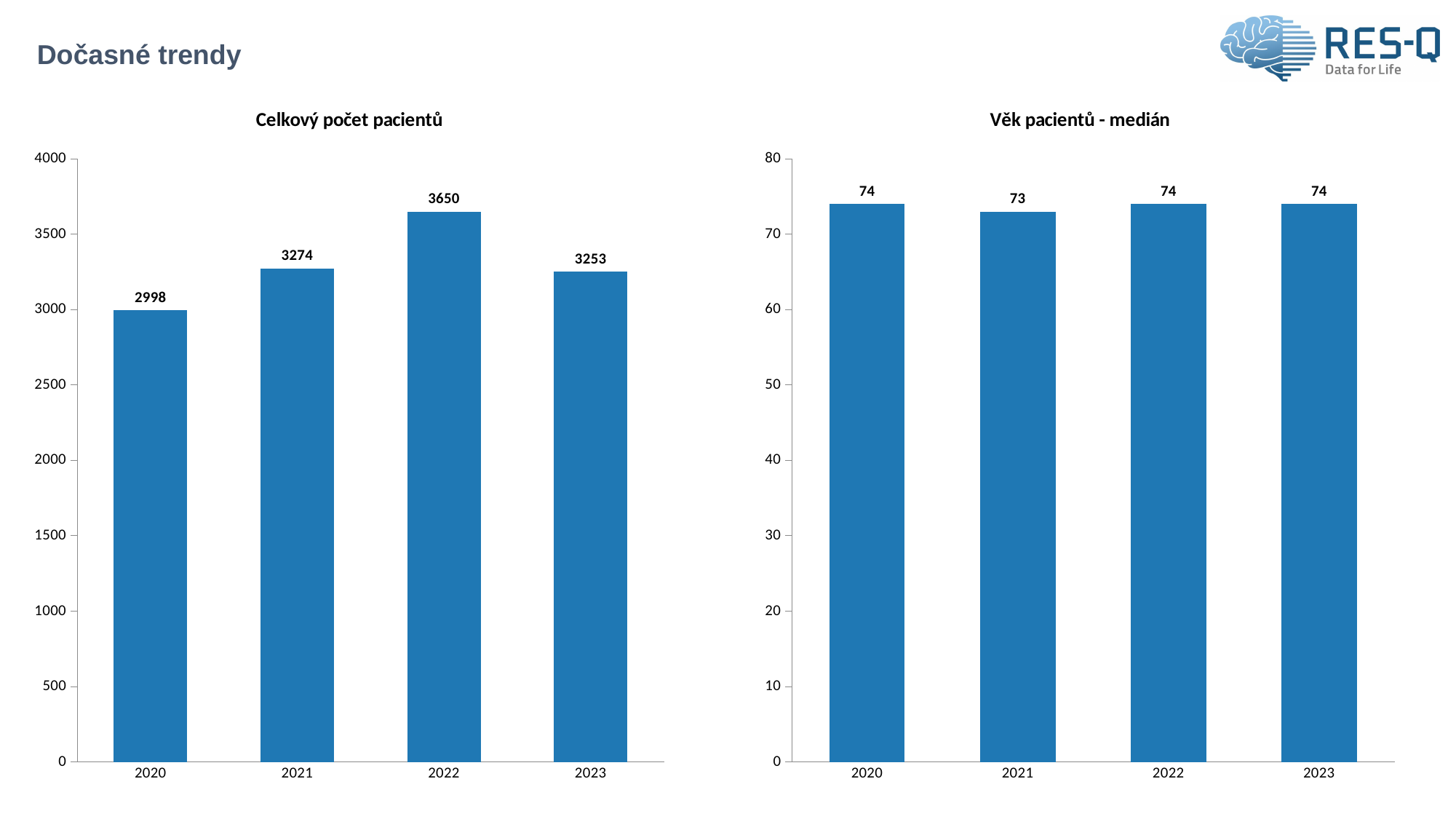
In the 'Věk pacientů - medián' chart, what is the difference between the values for 2020 and 2021? 1 In the 'Věk pacientů - medián' chart, what is the value for 2021? 73 What kind of chart is the 'Celkový počet pacientů' chart? bar chart In the 'Celkový počet pacientů' chart, is the value for 2020 greater or less than 3000? less In the 'Věk pacientů - medián' chart, which year has the lowest value? 2021 In the 'Celkový počet pacientů' chart, what is the difference between the values for 2022 and 2023? 397 In the 'Celkový počet pacientů' chart, which year has the highest value? 2022 In the 'Celkový počet pacientů' chart, what is the value for 2022? 3650 In the 'Celkový počet pacientů' chart, which year has the lowest value? 2020 In the 'Celkový počet pacientů' chart, which is larger, the value for 2021 or the value for 2023? 2021 In the 'Celkový počet pacientů' chart, what is the value for 2020? 2998 How many years are shown on the x axis of the 'Věk pacientů - medián' chart? 4